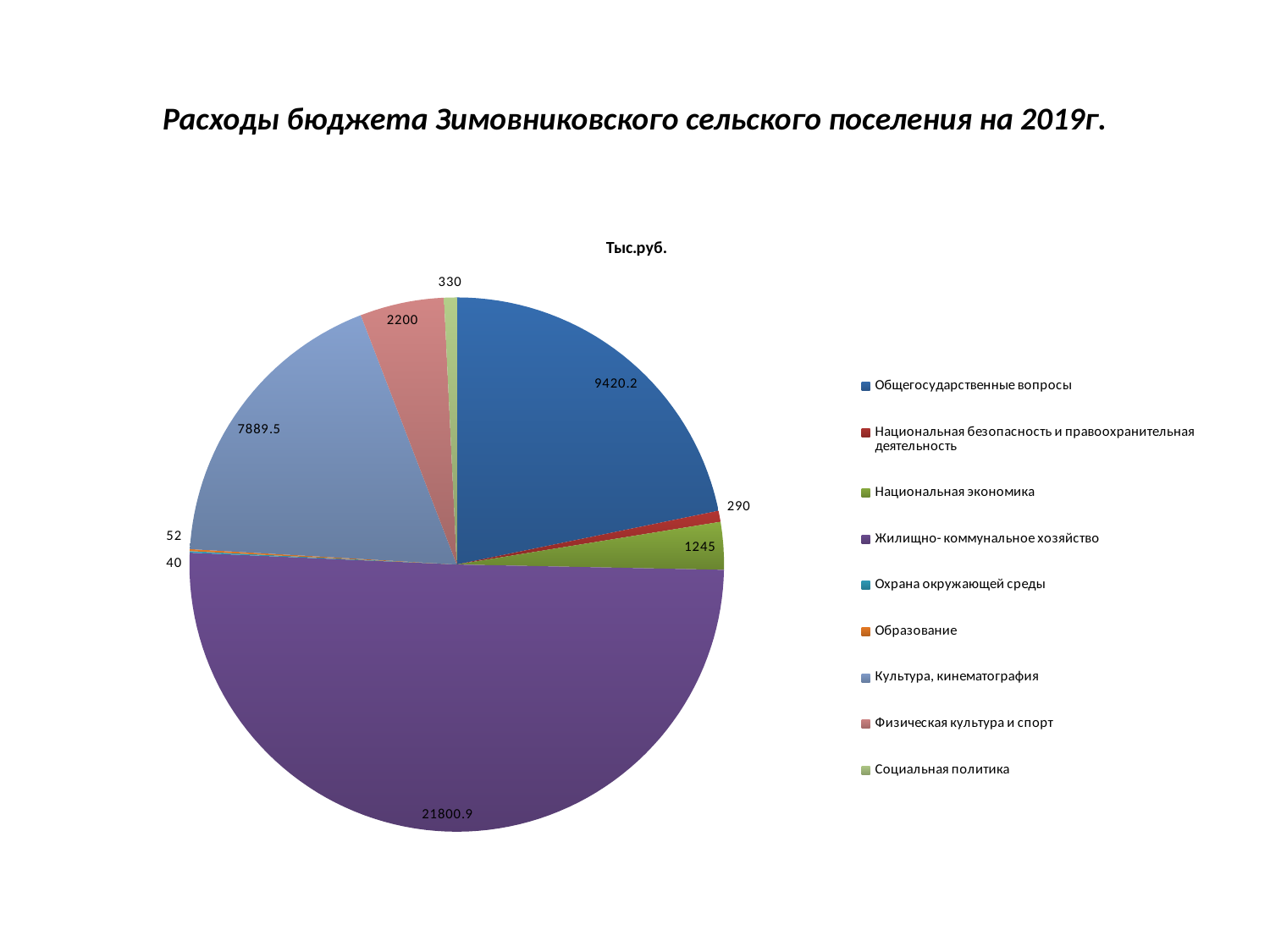
How many categories does the legend list? 9 What is the value for Общегосударственные вопросы? 9420.2 Which is larger, the value for Общегосударственные вопросы or the value for Культура, кинематография? Общегосударственные вопросы What is the value for Социальная политика? 330 What is the value for Жилищно-коммунальное хозяйство? 21800.9 What is the value for Национальная экономика? 1245 What is the title shown above the pie chart? Тыс.руб. What is the value for Культура, кинематография? 7889.5 What is the difference between the values for Жилищно-коммунальное хозяйство and Общегосударственные вопросы? 12380.7 What is the value for Физическая культура и спорт? 2200 What kind of chart is shown on the slide? pie chart Which category has the largest slice of the pie? Жилищно-коммунальное хозяйство